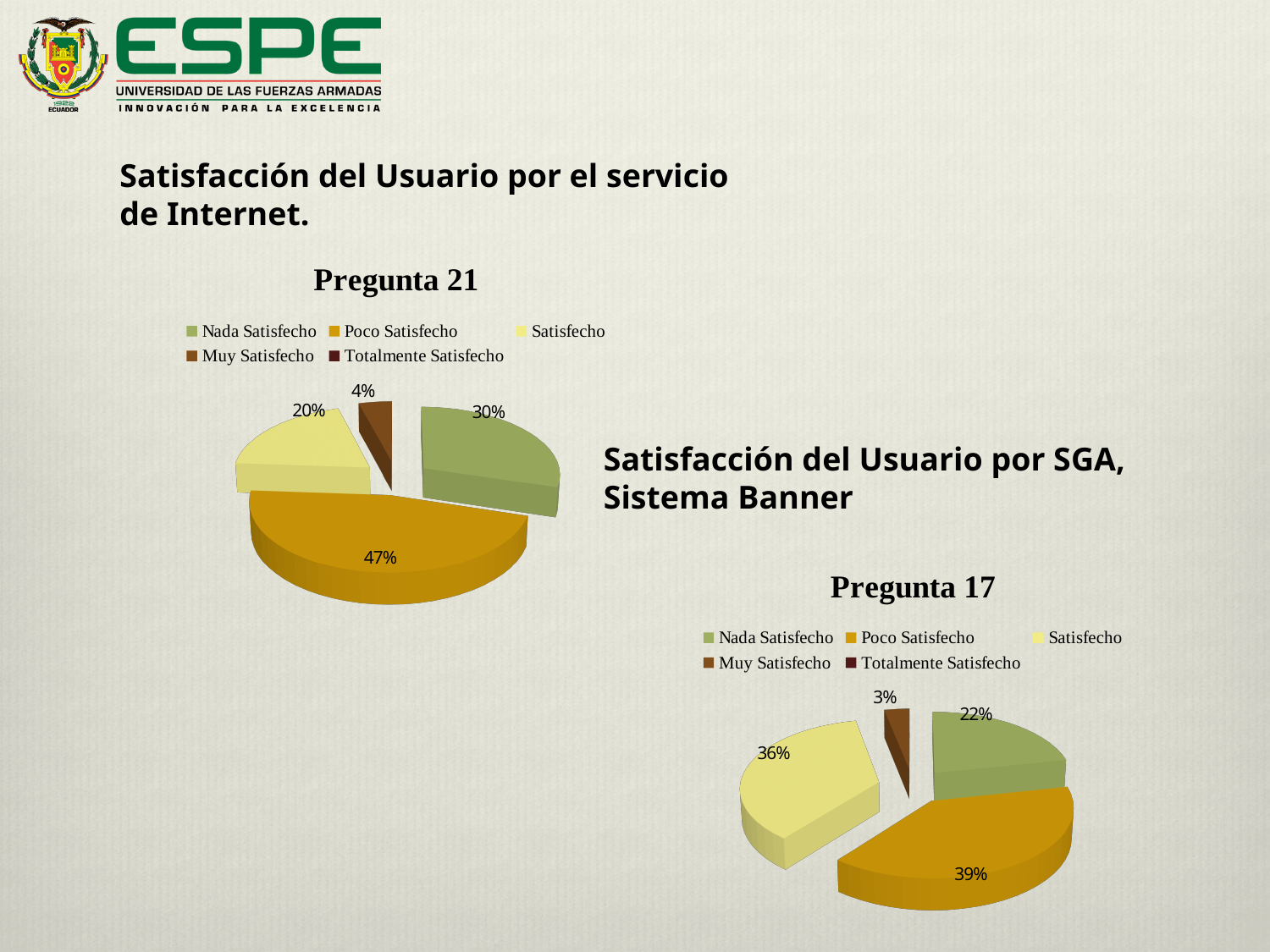
In the Pregunta 17 chart, which category has the largest slice? Poco Satisfecho In the Pregunta 21 chart, what percentage is shown for Poco Satisfecho? 47% In the Pregunta 21 chart, what percentage is shown for Nada Satisfecho? 30% In the Pregunta 17 chart, what percentage is shown for Satisfecho? 36% In the Pregunta 21 chart, which labelled slice is the smallest? Muy Satisfecho In the Pregunta 21 chart, which category has the largest slice? Poco Satisfecho In the Pregunta 17 chart, what is the difference between the Poco Satisfecho and Nada Satisfecho percentages? 17% What type of chart is the Pregunta 21 chart? Pie chart In the Pregunta 21 chart, what is the difference between the Poco Satisfecho and Satisfecho percentages? 27% In the Pregunta 17 chart, what percentage is shown for Muy Satisfecho? 3% In the Pregunta 17 chart, which is larger, Nada Satisfecho or Satisfecho? Satisfecho How many entries does the legend of the Pregunta 17 chart list? 5